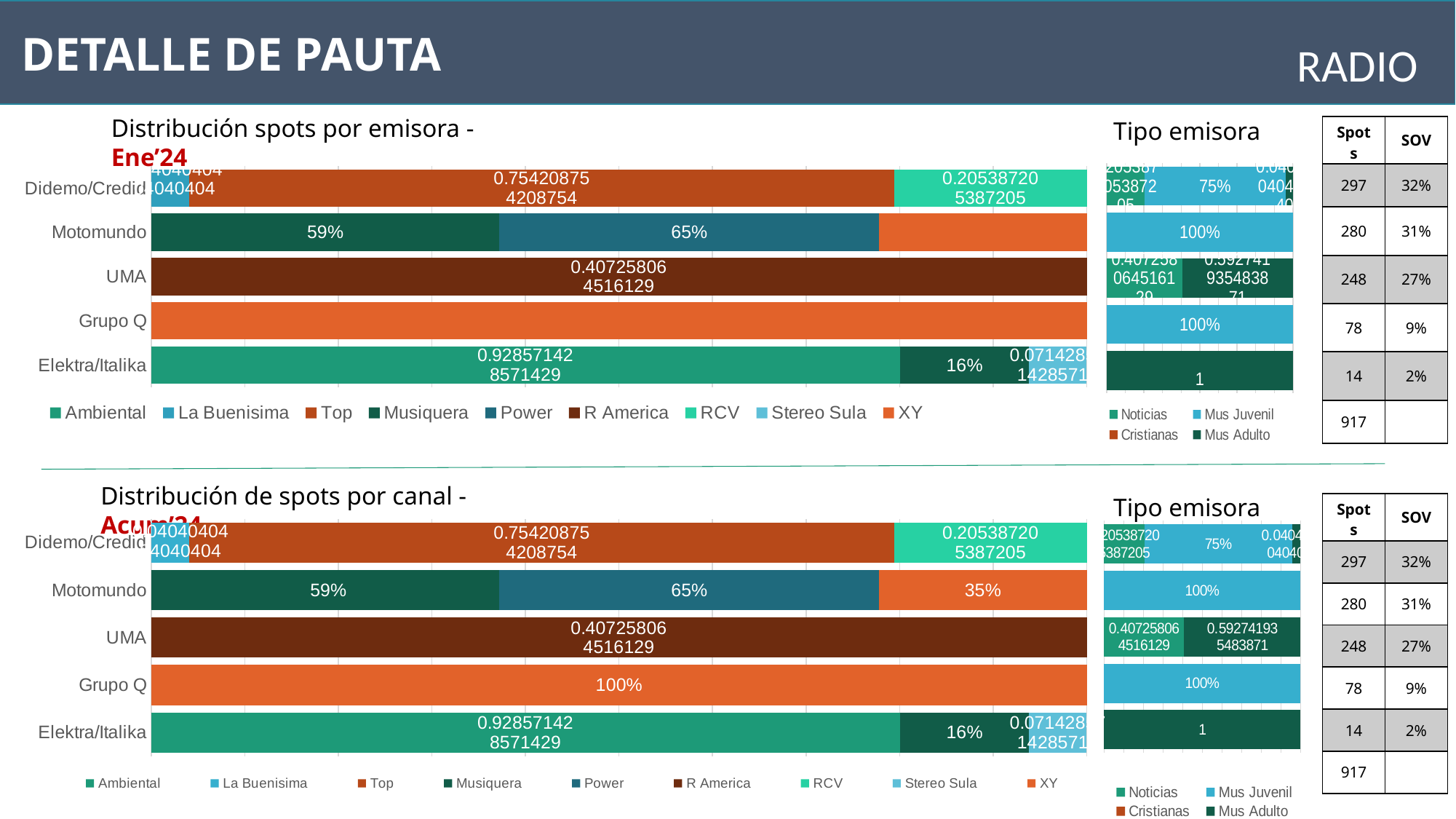
How many series does the legend of the 'Distribución spots por emisora - Ene'24' chart list? 9 What is the title of the bottom-left chart on the slide? Distribución de spots por canal - Acum'24 In the 'Distribución spots por emisora - Ene'24' chart, what is the Musiquera value for Motomundo? 59% In the 'Distribución de spots por canal - Acum'24' chart, what is the XY value for Grupo Q? 100% In the 'Distribución spots por emisora - Ene'24' chart, which is larger for Motomundo: the Musiquera value or the Power value? Power In the 'Distribución spots por emisora - Ene'24' chart, what is the Power value for Motomundo? 65% In the top 'Tipo emisora' chart, what is the Mus Juvenil value for Motomundo? 100% How many series does the legend of the top 'Tipo emisora' chart list? 4 What kind of chart is the 'Distribución spots por emisora - Ene'24' chart? bar chart How many categories (emisoras) are shown on the y axis of the 'Distribución spots por emisora - Ene'24' chart? 5 In the 'Distribución spots por emisora - Ene'24' chart, what is the Musiquera value for Elektra/Italika? 16% In the 'Distribución de spots por canal - Acum'24' chart, what is the XY value for Motomundo? 35%